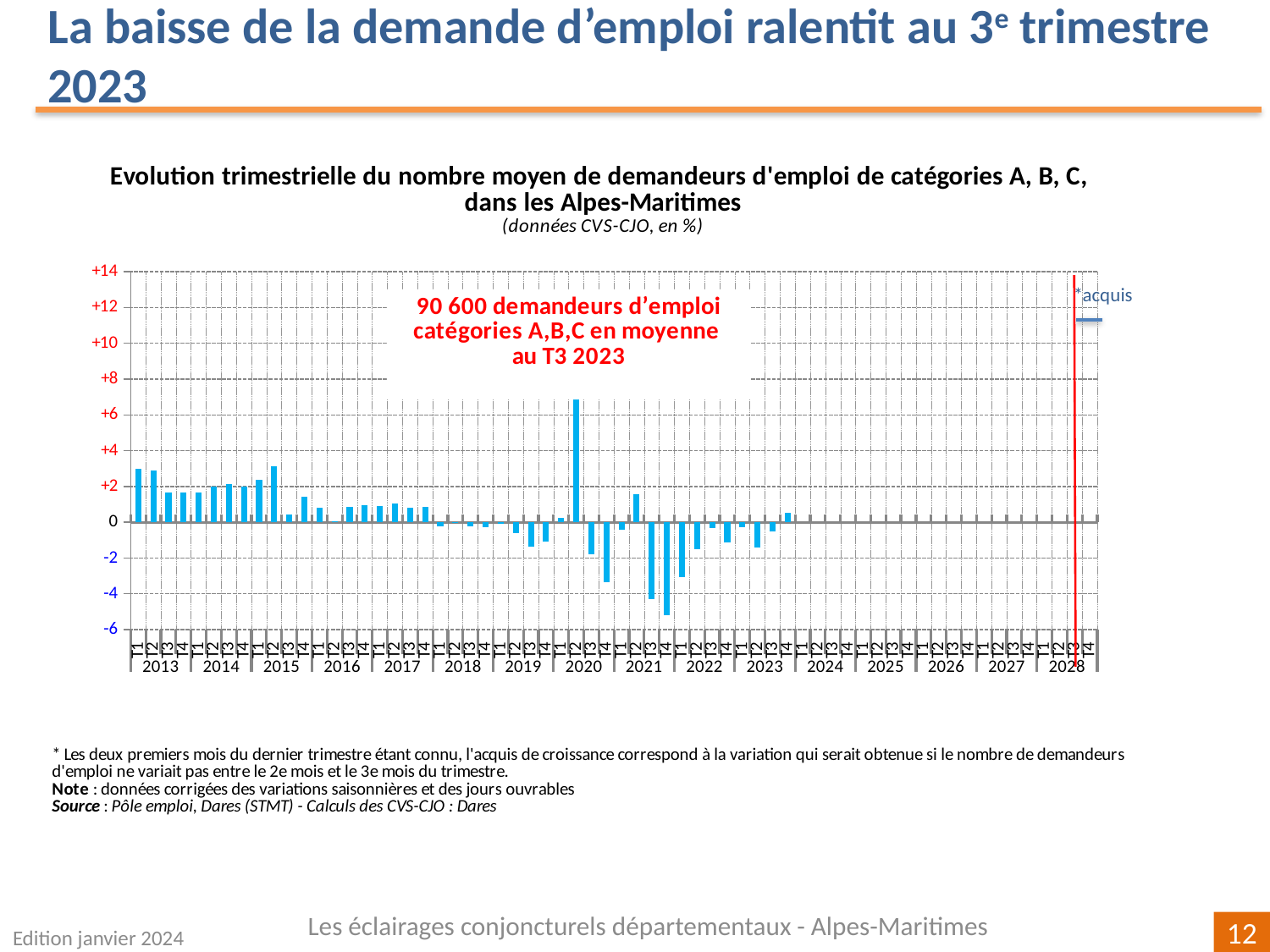
Which is larger, the value for T2 2020 or the value for T1 2013? T2 2020 Is the value for T2 2020 greater or less than +6? greater Is the value for T4 2021 greater or less than -4? less Which quarter has the lowest value in the chart? T4 2021 Which is lower, the value for T4 2021 or the value for T1 2021? T4 2021 Do the values rise or fall from T1 2021 to T4 2021? fall According to the annotation in the chart, how many demandeurs d'emploi catégories A,B,C were there on average in T3 2023? 90 600 Is the value for T3 2021 greater or less than -2? less What kind of chart is shown on the slide? bar chart What is the highest tick value shown on the vertical axis? +14 Which quarter has the highest value in the chart? T2 2020